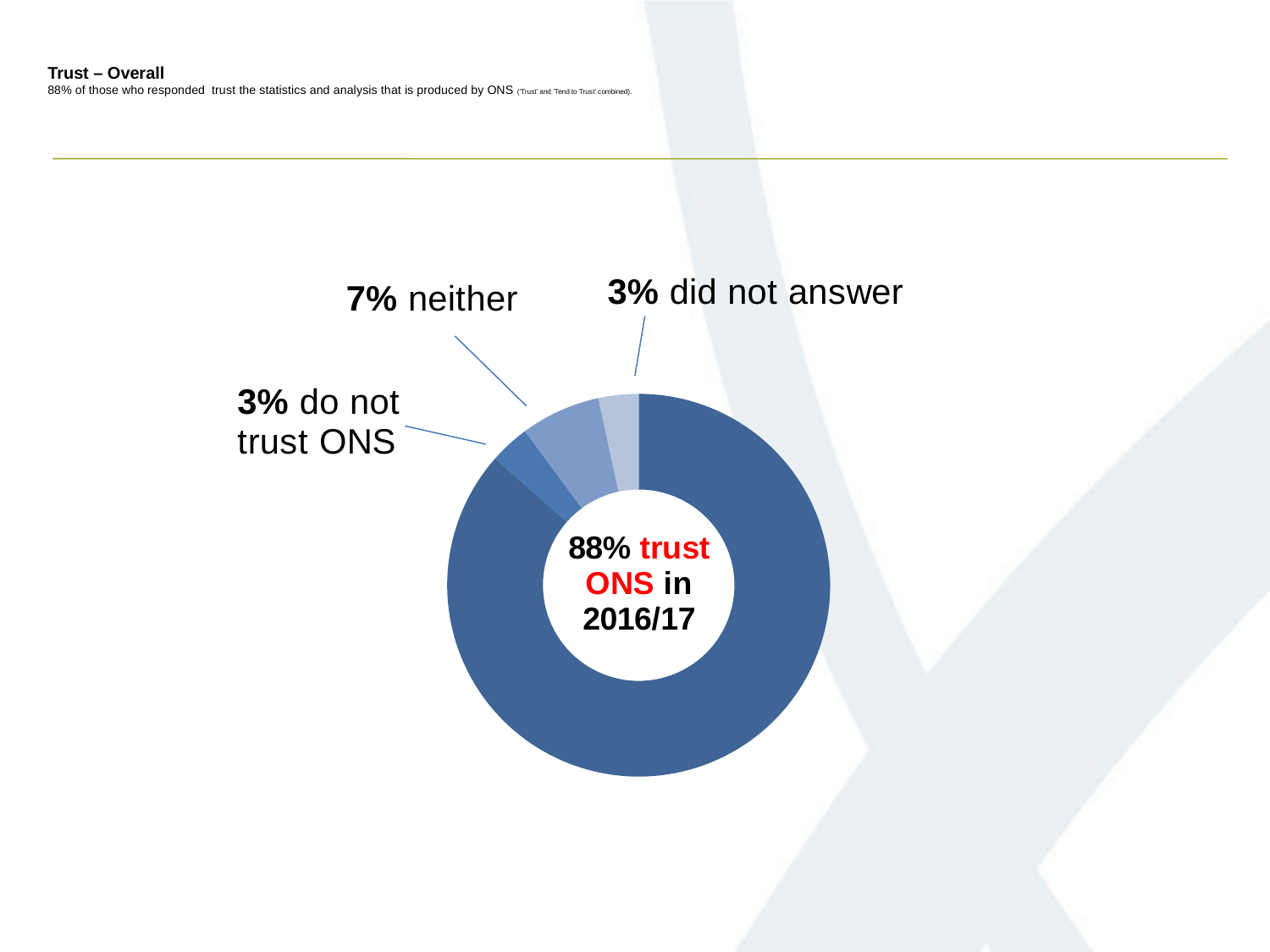
What percentage of respondents answered 'neither'? 7% What percentage of respondents did not answer? 3% Which is larger: the share that answered 'neither' or the share that do not trust ONS? Neither What is the combined share of 'do not trust ONS' and 'did not answer'? 6% What year does the chart's centre label refer to? 2016/17 What kind of chart is shown on the slide? Doughnut (pie) chart What percentage of respondents trust ONS in 2016/17? 88% What is the difference between the share that trust ONS and the share that answered 'neither'? 81 percentage points What is the title of the slide? Trust – Overall What percentage of respondents do not trust ONS? 3% How many segments does the chart have? 4 Which category has the largest share of the chart? Trust ONS